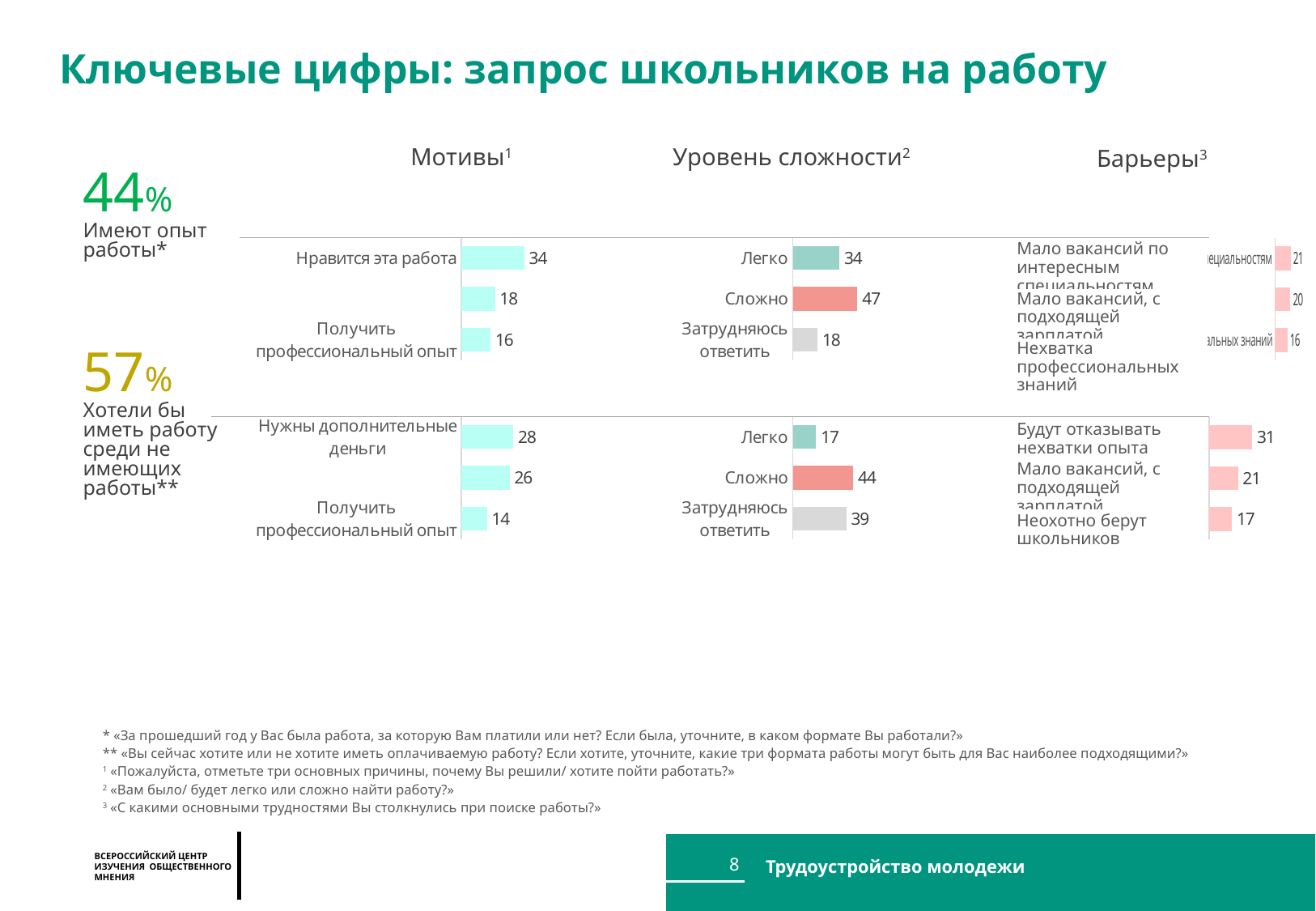
In the bottom-row 'Уровень сложности' chart (for those who would like a job), what is the value for 'Затрудняюсь ответить'? 39 In the top-row 'Мотивы' chart, what is the value for 'Нравится эта работа'? 34 In the top-row 'Уровень сложности' chart (for those with work experience), what is the value for 'Сложно'? 47 In the bottom-row 'Барьеры' chart, which category has the highest value? Будут отказывать нехватки опыта How many bars are in the bottom-row 'Уровень сложности' chart? 3 In the bottom-row 'Барьеры' chart, what is the value for 'Неохотно берут школьников'? 17 In the bottom-row 'Мотивы' chart, what is the value for 'Нужны дополнительные деньги'? 28 In the bottom-row 'Барьеры' chart, which is larger: 'Мало вакансий, с подходящей зарплатой' or 'Неохотно берут школьников'? Мало вакансий, с подходящей зарплатой In the top-row 'Уровень сложности' chart, which category has the lowest value? Затрудняюсь ответить In the bottom-row 'Уровень сложности' chart, what is the difference between 'Сложно' and 'Легко'? 27 What type of chart is used for 'Уровень сложности'? Bar chart In the top-row 'Мотивы' chart, what is the difference between 'Нравится эта работа' and 'Получить профессиональный опыт'? 18